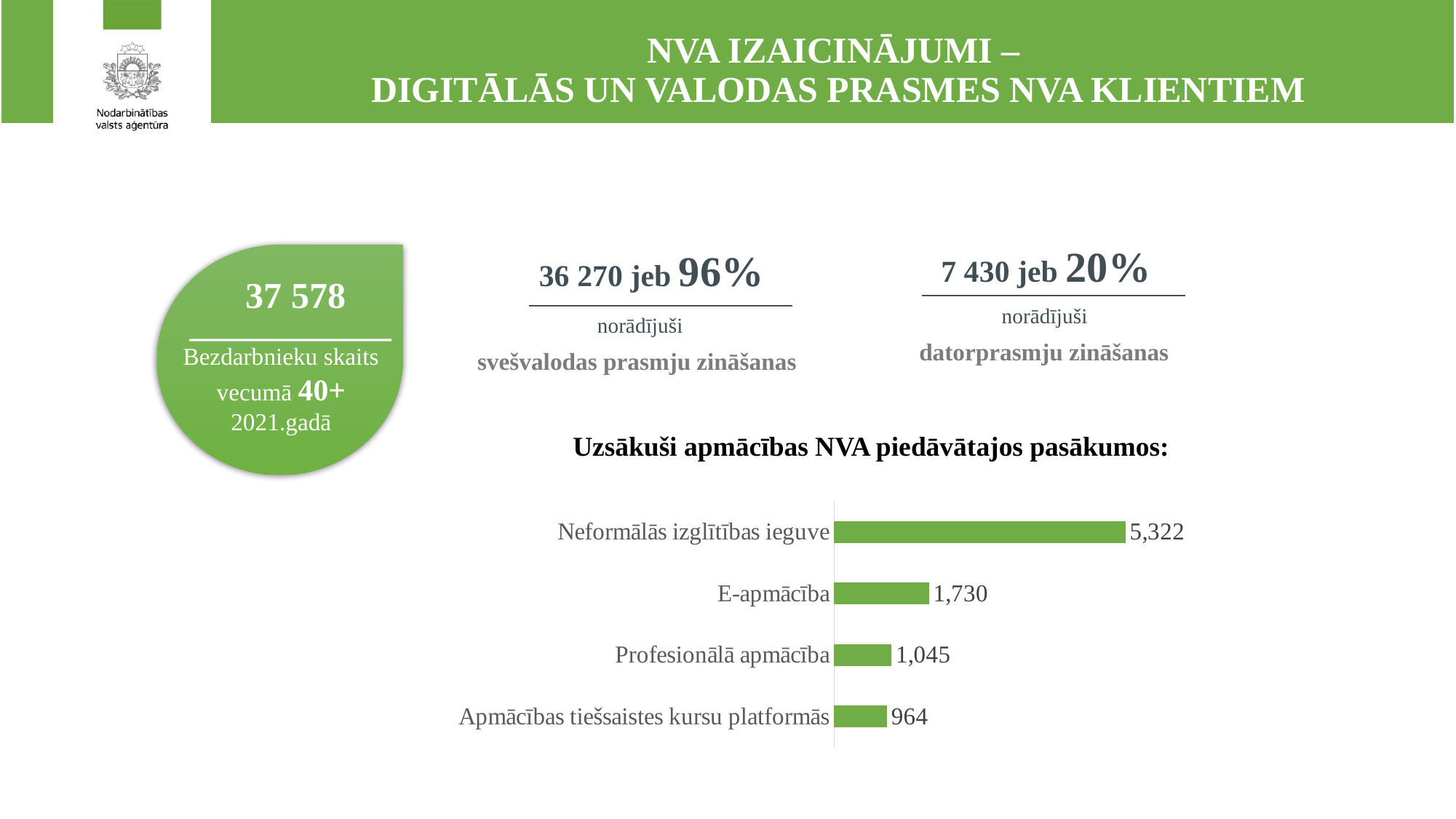
Which is larger, the value for E-apmācība or the value for Profesionālā apmācība? E-apmācība What is the difference between the values for Neformālās izglītības ieguve and E-apmācība? 3,592 What is the value for E-apmācība? 1,730 What is the value for Apmācības tiešsaistes kursu platformās? 964 What is the heading above the chart? Uzsākuši apmācības NVA piedāvātajos pasākumos: What is the value for Neformālās izglītības ieguve? 5,322 How many categories are shown in the chart? 4 What kind of chart is shown on the slide? Bar chart What is the difference between the values for Profesionālā apmācība and Apmācības tiešsaistes kursu platformās? 81 Which category has the highest value? Neformālās izglītības ieguve What is the value for Profesionālā apmācība? 1,045 Which category has the lowest value? Apmācības tiešsaistes kursu platformās